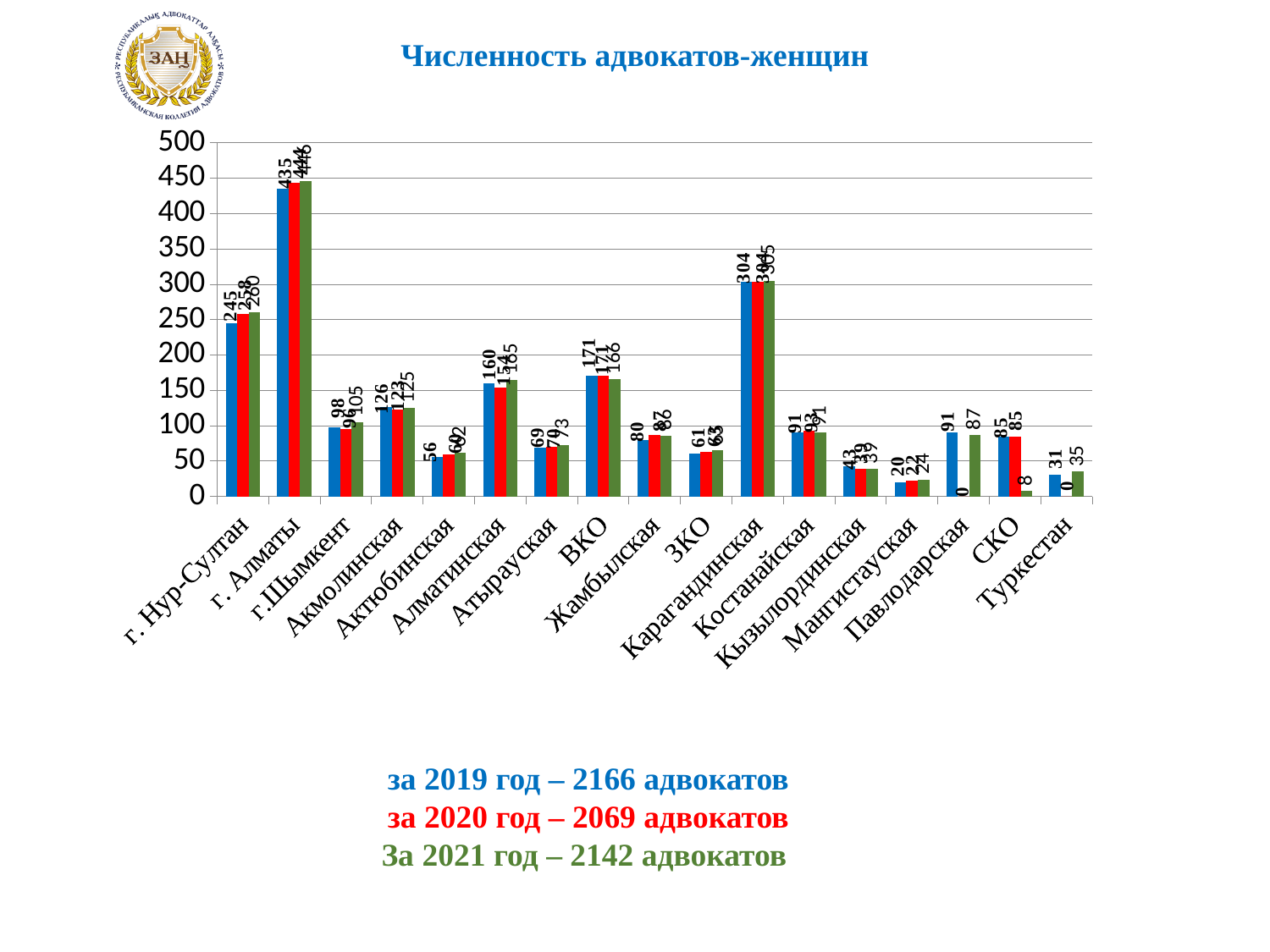
Which region has the highest bars in the chart? г. Алматы Which is larger for 2019 (blue bars): г. Алматы or Карагандинская? г. Алматы What is the value of the red (2020) bar for Павлодарская? 0 What is the value of the blue (2019) bar for г. Нур-Султан? 245 Which region has the lowest blue (2019) bar? Мангистауская What is the value of the green (2021) bar for г.Шымкент? 105 What is the difference between the green (2021) and blue (2019) bars for г. Нур-Султан? 15 How many regions (categories) are shown on the x axis of the chart? 17 What is the title of the chart? Численность адвокатов-женщин What is the value of the blue (2019) bar for ВКО? 171 What kind of chart is shown on the slide? bar chart What is the value of the green (2021) bar for Туркестан? 35